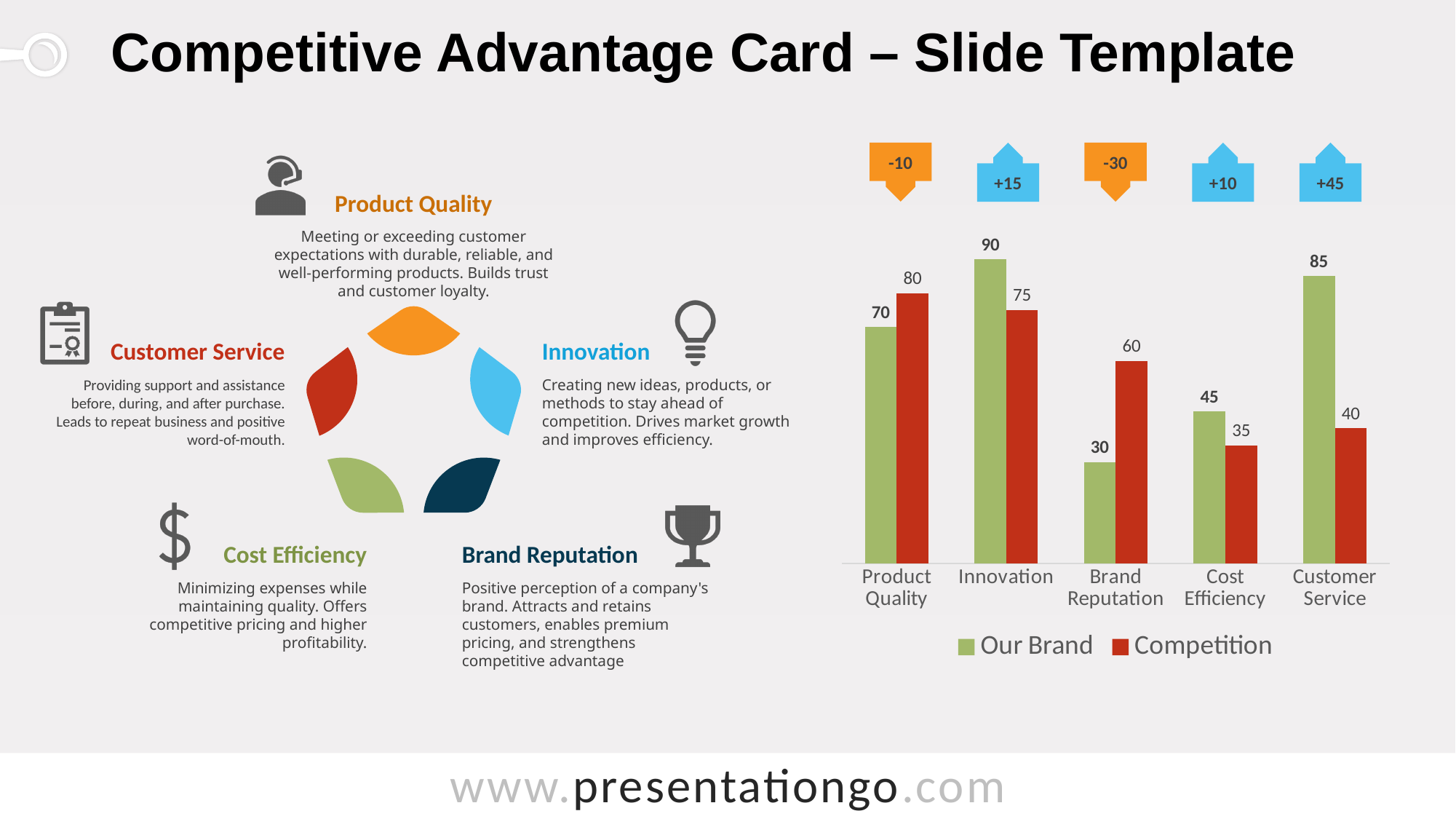
What is the value for Our Brand in the Customer Service category? 85 How many categories are shown on the x axis of the chart? 5 What is the value for Our Brand in the Innovation category? 90 What is the value for Competition in the Product Quality category? 80 Which category has the highest value for Our Brand? Innovation What is the value for Competition in the Brand Reputation category? 60 Which category has the lowest value for Competition? Cost Efficiency How many series does the chart legend list? 2 Which is larger in the Brand Reputation category, Our Brand or Competition? Competition What is the difference between Our Brand and Competition in the Customer Service category? 45 What are the two series named in the chart legend? Our Brand and Competition What kind of chart is shown on the slide? Bar chart